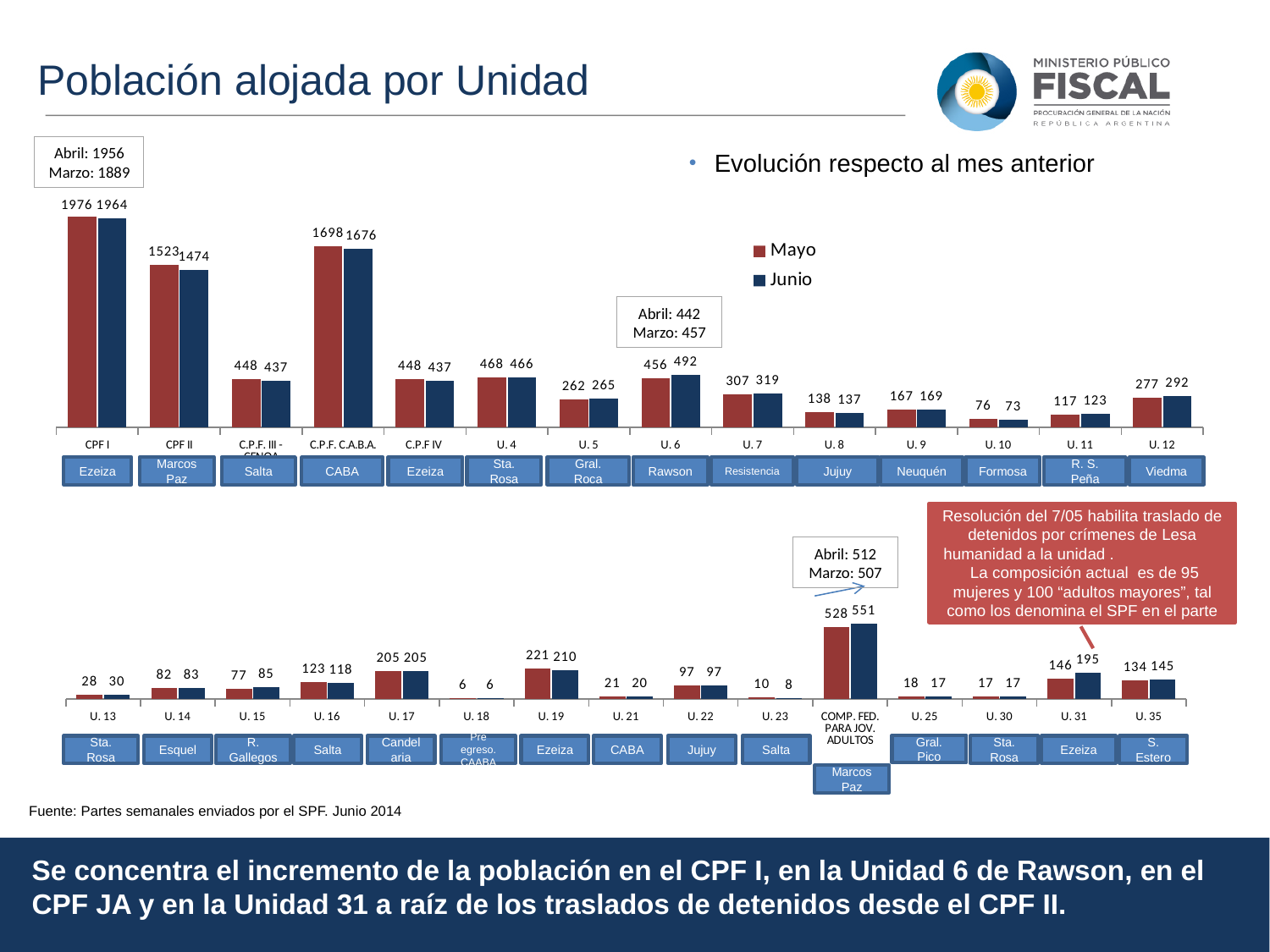
In the top chart, what is the difference between the Mayo and Junio values for CPF II? 49 In the top chart, what is the Junio value for U. 6? 492 In the bottom chart, what is the difference between the Junio and Mayo values for U. 31? 49 In the top chart, what is the Mayo value for CPF II? 1523 In the top chart, which category has the highest Mayo value? CPF I In the top chart, how many categories are shown on the x axis? 14 In the bottom chart, which category has the highest Junio value? COMP. FED. PARA JOV. ADULTOS In the top chart, which category has the lowest Junio value? U. 10 How many series does the legend list? 2 In the bottom chart, is the Mayo value for U. 19 larger or the Mayo value for U. 17? U. 19 In the bottom chart, what is the Junio value for U. 31? 195 What type of chart is the bottom chart? Bar chart